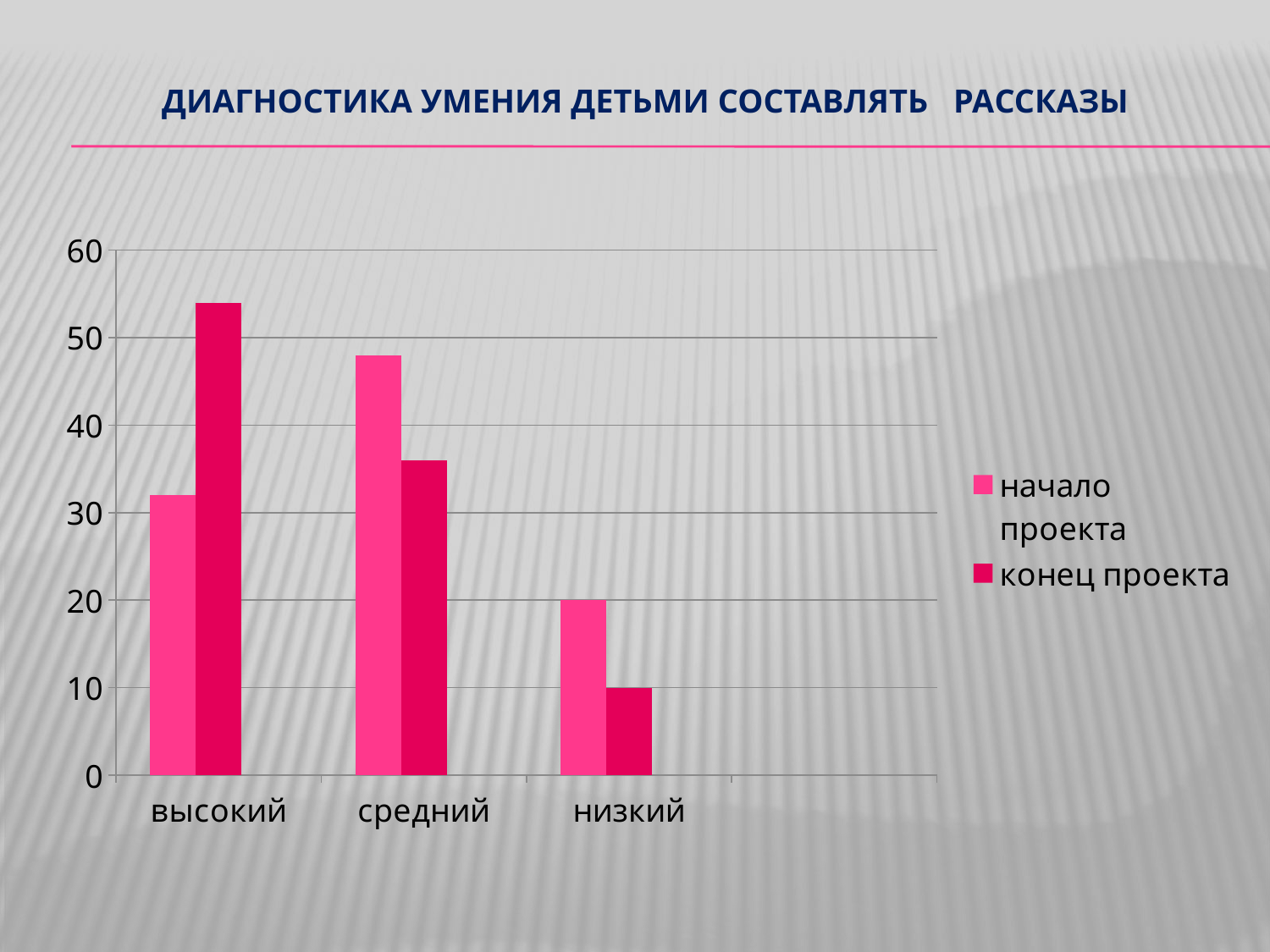
Which category has the lowest value in the начало проекта series? низкий What is the value for низкий in the конец проекта series? 10 What kind of chart is shown on the slide? bar chart What is the value for низкий in the начало проекта series? 20 How many series does the legend list? 2 What is the title of the chart on the slide? ДИАГНОСТИКА УМЕНИЯ ДЕТЬМИ СОСТАВЛЯТЬ РАССКАЗЫ Which category has the highest value in the конец проекта series? высокий Is the value for высокий in the начало проекта series greater or less than 40? less How many categories are shown on the x axis? 3 Is the value for средний in the конец проекта series greater or less than 40? less For the category высокий, which series has the larger value: начало проекта or конец проекта? конец проекта Is the value for высокий in the конец проекта series greater or less than 50? greater